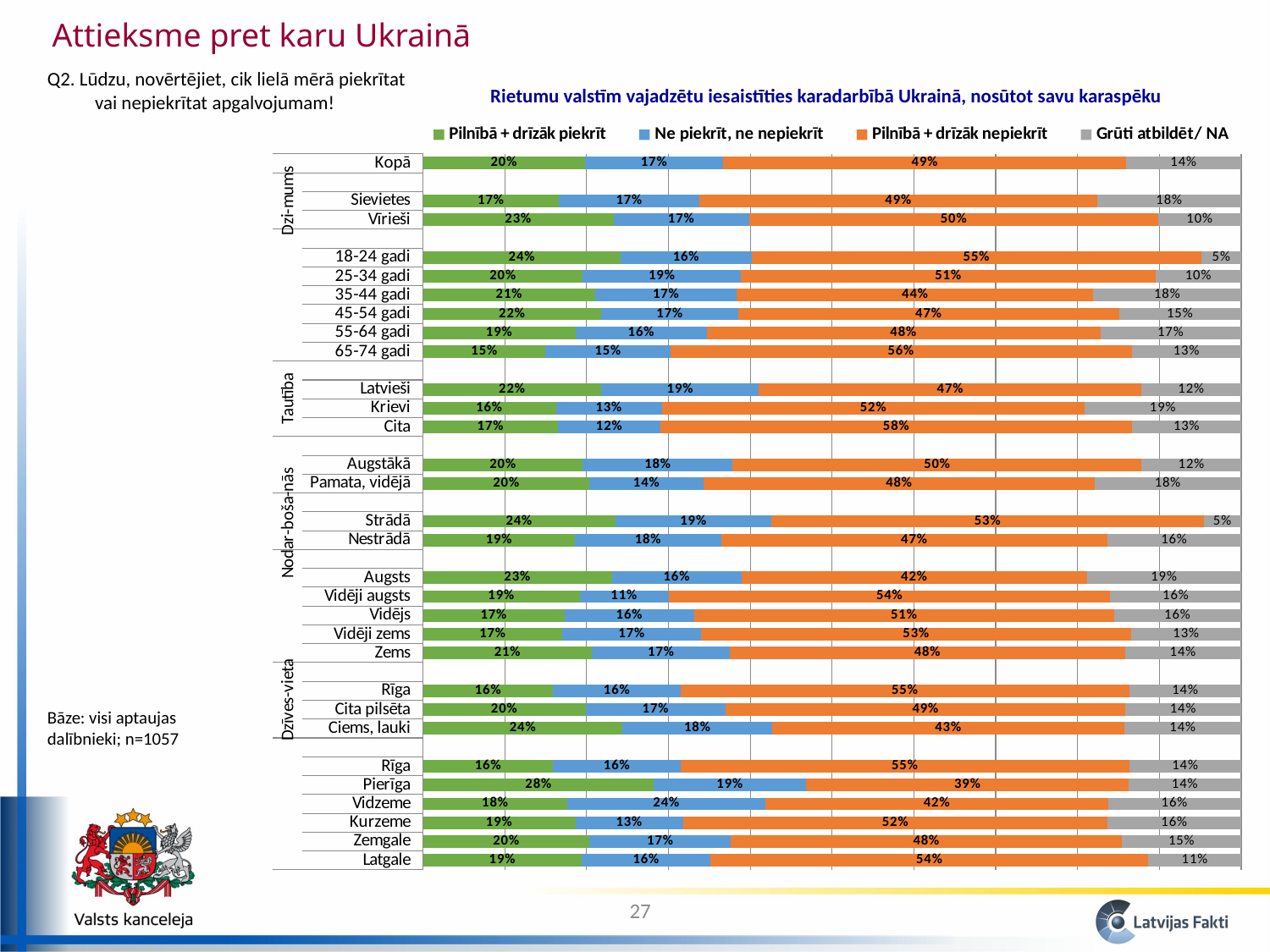
Which category has the highest value for 'Pilnībā + drīzāk nepiekrīt'? Cita How many series does the legend list? 4 What is the difference between the 'Pilnībā + drīzāk nepiekrīt' values for Vīrieši and Sievietes? 1% Which category has the lowest value for 'Pilnībā + drīzāk nepiekrīt'? Pierīga What kind of chart is shown on the slide? Stacked bar chart What is the title of the chart? Rietumu valstīm vajadzētu iesaistīties karadarbībā Ukrainā, nosūtot savu karaspēku What is the value of 'Ne piekrīt, ne nepiekrīt' for Vidzeme? 24% What is the value of 'Pilnībā + drīzāk piekrīt' for Pierīga? 28% Which has a larger 'Pilnībā + drīzāk piekrīt' value, Strādā or Nestrādā? Strādā What is the value of 'Pilnībā + drīzāk nepiekrīt' for Kopā? 49% What is the difference between the 'Pilnībā + drīzāk nepiekrīt' values for Rīga and Ciems, lauki? 12% What is the value of 'Grūti atbildēt/ NA' for 18-24 gadi? 5%